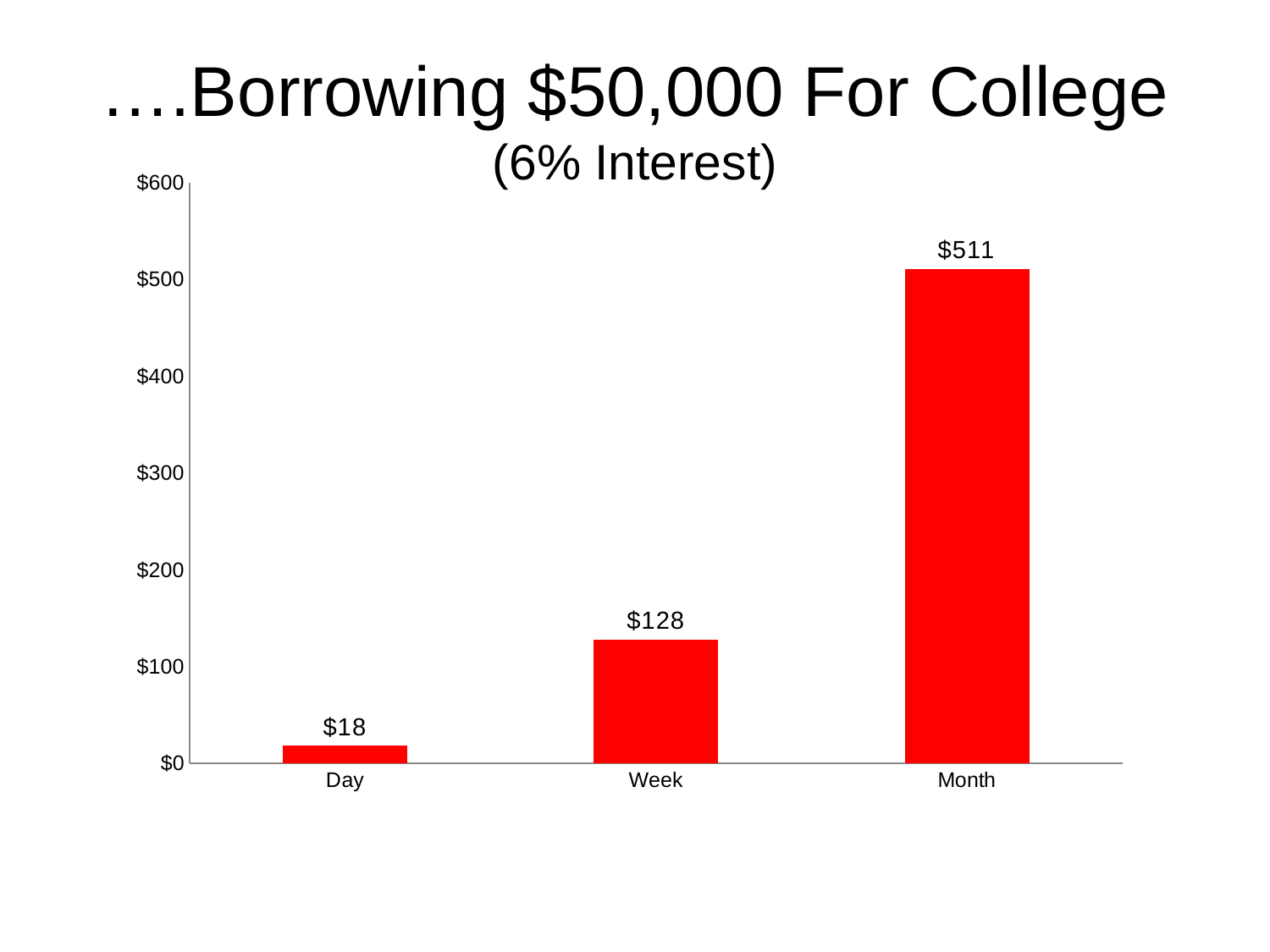
Which category has the lowest value? Day Which is larger, the value for Week or the value for Day? Week Do the values rise or fall from Day to Month along the x axis? rise What is the value for Month? $511 Which category has the highest value? Month How many categories are shown on the x axis? 3 What is the difference between the values for Month and Week? $383 What kind of chart is shown on the slide? bar chart What is the value for Week? $128 Is the value for Month greater or less than $500? greater What is the value for Day? $18 What is the difference between the values for Week and Day? $110